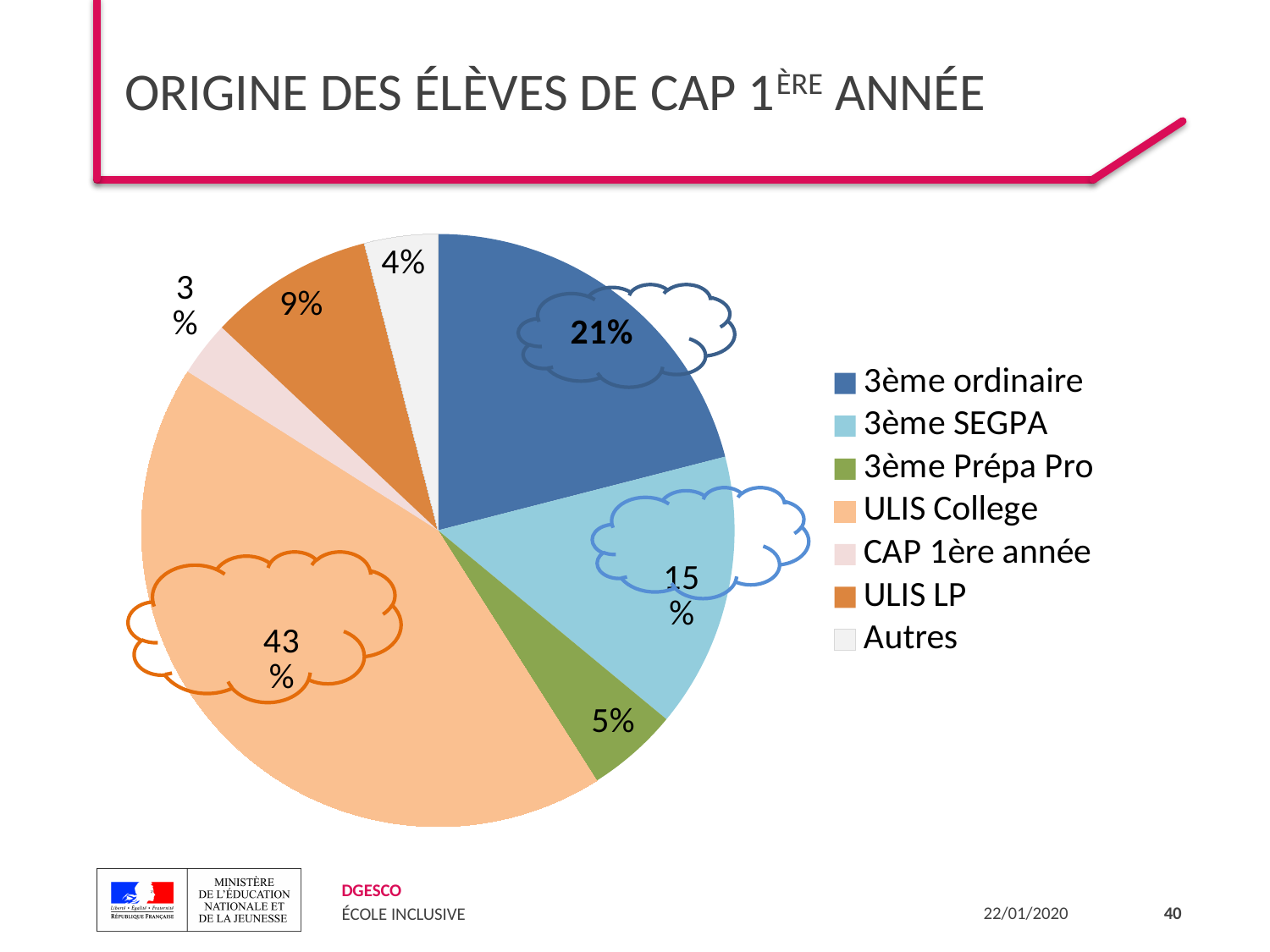
What kind of chart is shown on the slide? pie chart What is the value shown for 3ème SEGPA? 15% What is the value shown for ULIS LP? 9% Which is larger, the share for 3ème SEGPA or the share for ULIS LP? 3ème SEGPA What is the value shown for 3ème ordinaire? 21% How many categories does the legend list? 7 What share of the pie does ULIS College represent? 43% Which category has the smallest slice of the pie? CAP 1ère année What is the value shown for 3ème Prépa Pro? 5% What is the title of the slide containing the chart? ORIGINE DES ÉLÈVES DE CAP 1ÈRE ANNÉE What is the difference between the shares of ULIS College and 3ème ordinaire? 22% Which category has the largest slice of the pie? ULIS College